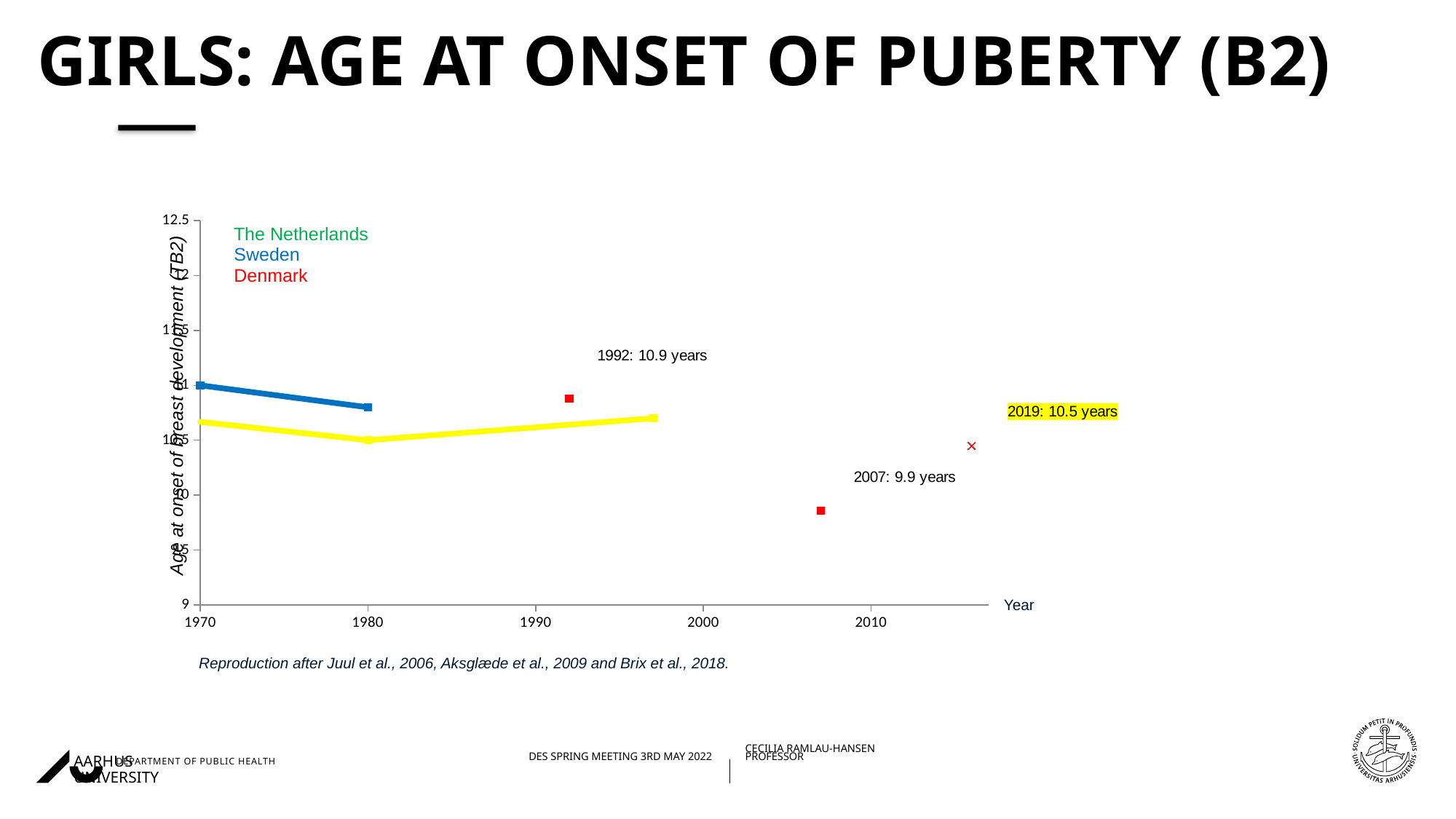
Does the Sweden (blue) line rise or fall between 1970 and 1980? fall What is the difference between the labelled 1992 value (10.9 years) and the labelled 2007 value (9.9 years)? 1.0 years Which labelled year has the highest age at onset of puberty: 1992, 2007 or 2019? 1992 According to the data label, what was the age at onset of puberty for Denmark in 1992? 10.9 years What colour is used for Denmark in the chart legend? red Is the value of the Sweden (blue) line in 1970 greater or less than 10.5? greater How many countries are listed in the chart legend? 3 What kind of chart is shown on the slide? line chart Which labelled year has the lowest age at onset of puberty: 1992, 2007 or 2019? 2007 What value is labelled for the year 2007 on the chart? 9.9 years Is the labelled value for 1992 larger or smaller than the labelled value for 2019? larger What value is shown in the highlighted label for 2019? 10.5 years